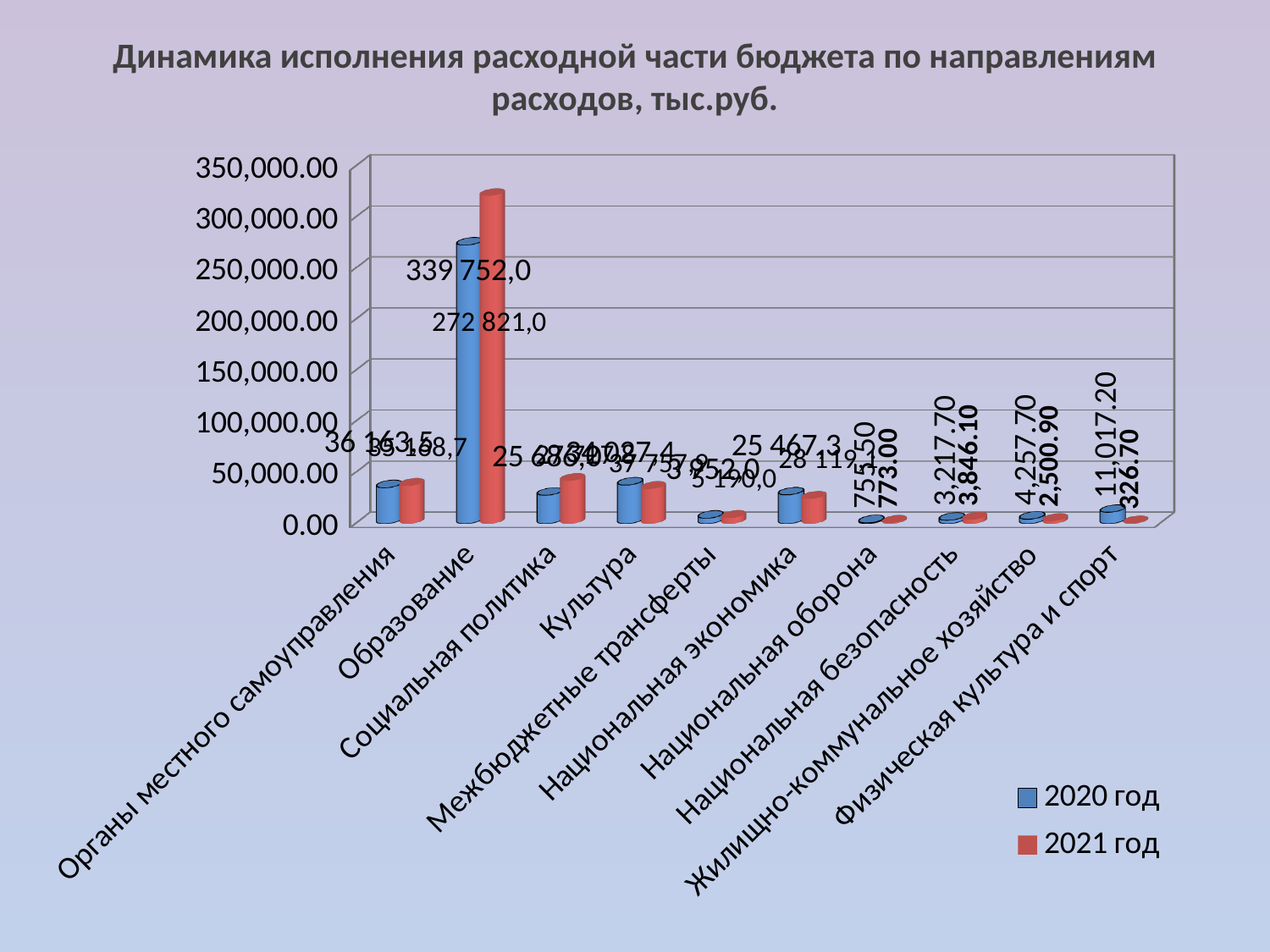
What are the two entries listed in the legend? 2020 год and 2021 год What is the value for Образование in 2020 год? 272 821,0 How many series does the legend list? 2 What is the value for Образование in 2021 год? 339 752,0 How many expenditure categories are shown on the x axis? 10 What is the difference between the 2021 год and 2020 год values for Национальная безопасность? 628.40 Is the 2020 год value for Образование greater or less than 250,000.00? greater What is the value for Национальная оборона in 2021 год? 773.00 Which category has the highest value for 2021 год? Образование What is the value for Физическая культура и спорт in 2020 год? 11,017.20 For Жилищно-коммунальное хозяйство, which year has the larger value, 2020 год or 2021 год? 2020 год What kind of chart is shown on the slide? bar chart